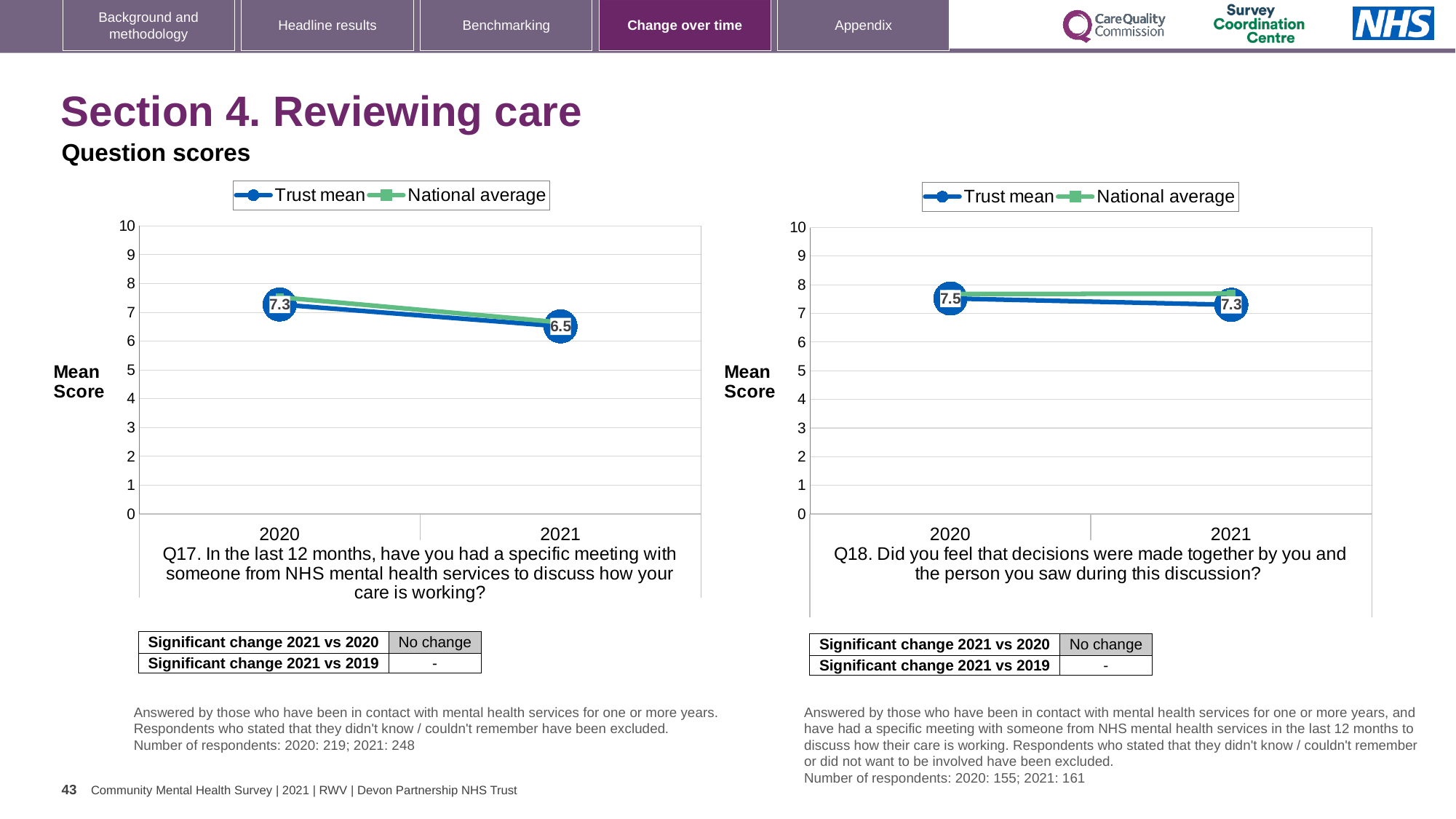
In the Q17 chart (left), is the Trust mean for 2021 greater or less than 7? less In the Q18 chart (right), what is the Trust mean for 2021? 7.3 In the Q18 chart (right), what is the difference between the Trust mean in 2020 and in 2021? 0.2 In the Q18 chart (right), which year has the higher Trust mean, 2020 or 2021? 2020 In the Q17 chart (left), by how much did the Trust mean change from 2020 to 2021? 0.8 How many series does the legend of the Q18 chart (right) list? 2 In the Q17 chart (left), does the Trust mean rise or fall from 2020 to 2021? fall In the Q17 chart (left), what is the Trust mean for 2020? 7.3 In the Q17 chart (left), what is the Trust mean for 2021? 6.5 How many years are plotted on the x axis of the Q17 chart (left)? 2 What kind of chart is used for Q18 (right)? line chart In the Q18 chart (right), what is the Trust mean for 2020? 7.5